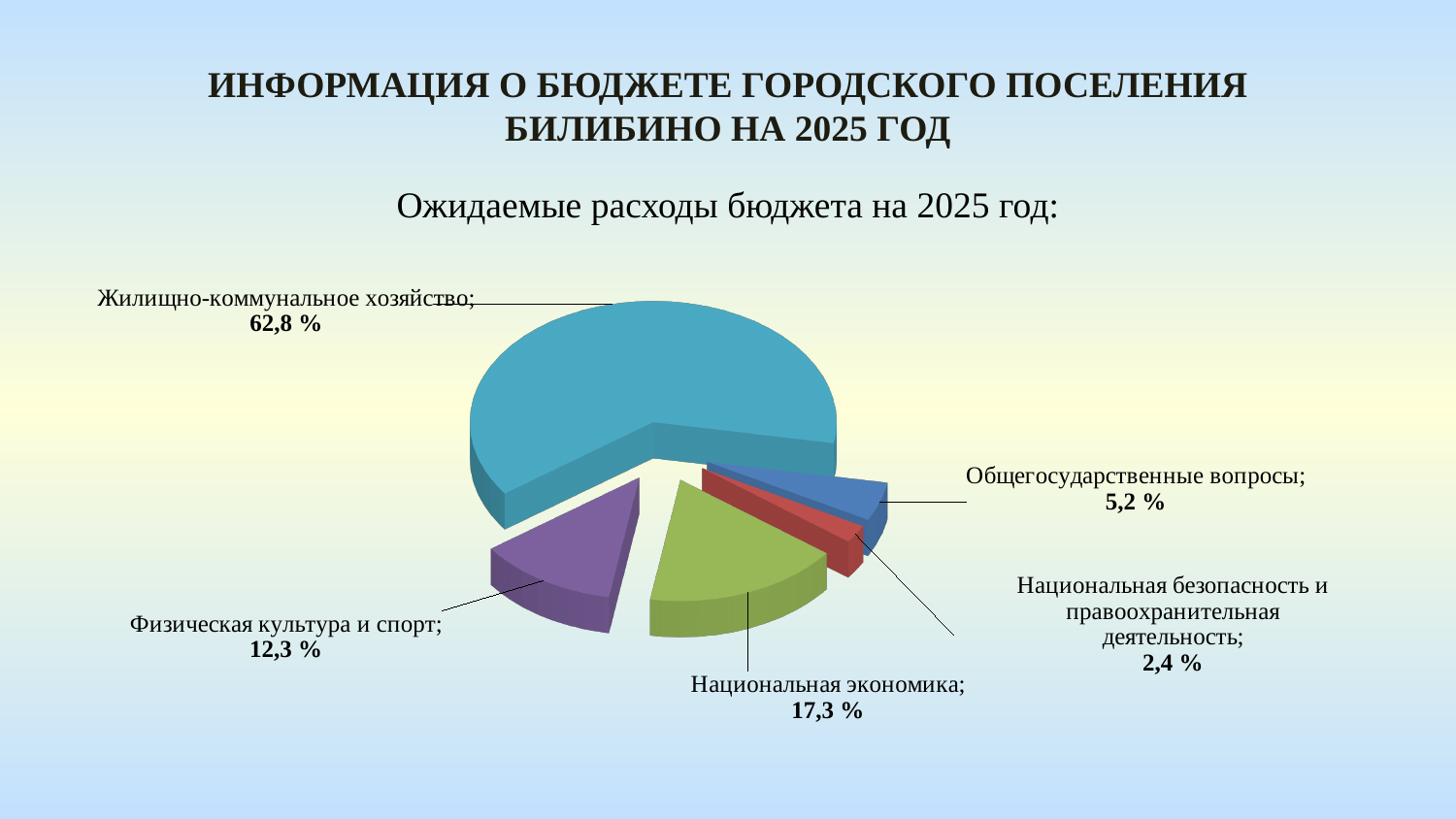
What share is shown for Национальная безопасность и правоохранительная деятельность? 2,4 % What is the difference in percentage points between Жилищно-коммунальное хозяйство and Национальная экономика? 45,5 What is the value shown for Национальная экономика? 17,3 % What is the value for Общегосударственные вопросы? 5,2 % What is the difference in percentage points between Общегосударственные вопросы and Национальная безопасность и правоохранительная деятельность? 2,8 Which category has the smallest slice of the pie? Национальная безопасность и правоохранительная деятельность Which category has the largest slice of the pie? Жилищно-коммунальное хозяйство What percentage is shown for Физическая культура и спорт? 12,3 % What share of the pie does Жилищно-коммунальное хозяйство have? 62,8 % What type of chart is shown on the slide? Pie chart Which is larger: Национальная экономика or Физическая культура и спорт? Национальная экономика How many categories are shown in the pie chart? 5